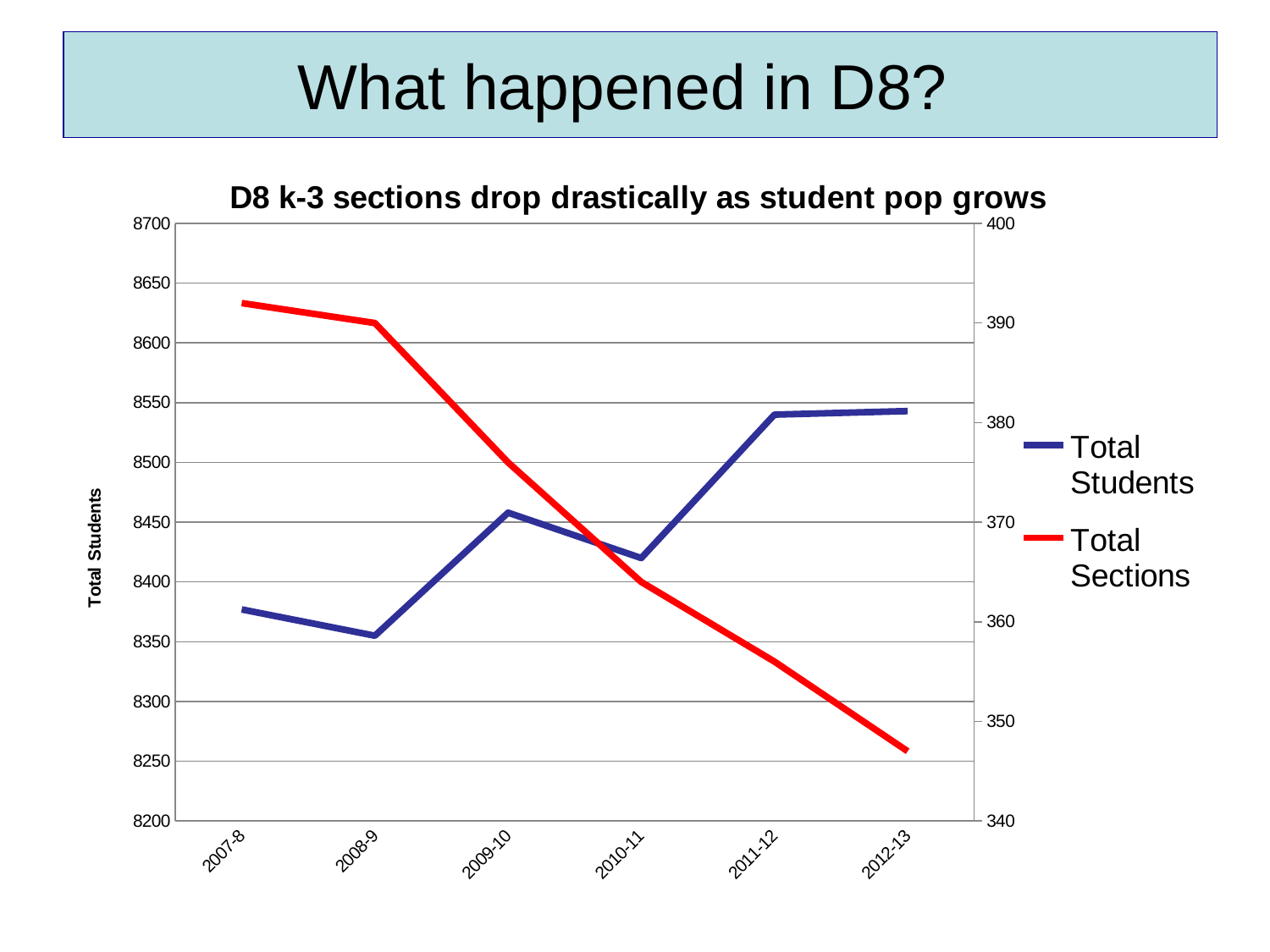
What is the title of the chart? D8 k-3 sections drop drastically as student pop grows Do the Total Sections values rise or fall from 2007-8 to 2012-13? fall How many series does the legend list? 2 Is the Total Students value for 2007-8 greater or less than 8400? less Which is larger, Total Students in 2009-10 or Total Students in 2008-9? 2009-10 In which school year is Total Sections highest? 2007-8 Is the Total Sections value for 2012-13 greater or less than 350? less What kind of chart is shown on the slide? line chart In which school year is Total Sections lowest? 2012-13 In which school year is Total Students lowest? 2008-9 Is the Total Students value for 2011-12 greater or less than 8500? greater How many school years are plotted along the x axis? 6